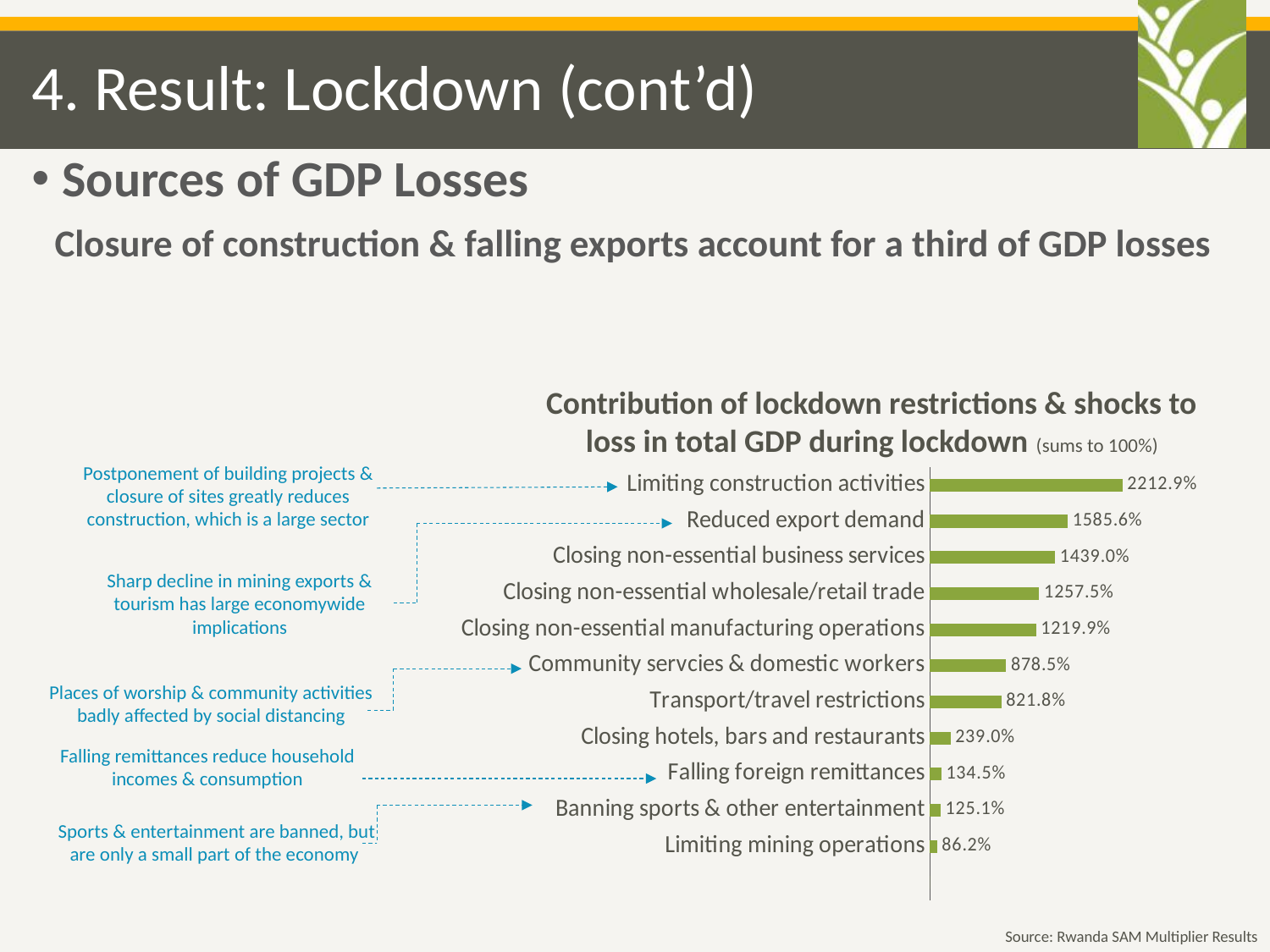
Which is larger, the value for Closing non-essential business services or the value for Closing non-essential manufacturing operations? Closing non-essential business services Which category has the highest value? Limiting construction activities What is the title of the chart? Contribution of lockdown restrictions & shocks to loss in total GDP during lockdown What kind of chart is shown on the slide? Bar chart What is the value for Limiting construction activities? 2212.9% What is the difference between the values for Closing hotels, bars and restaurants and Limiting mining operations? 152.8% What is the value for Transport/travel restrictions? 821.8% What is the difference between the values for Limiting construction activities and Reduced export demand? 627.3% What is the value for Closing non-essential wholesale/retail trade? 1257.5% What is the value for Falling foreign remittances? 134.5% How many categories are shown in the chart? 11 Which category has the lowest value? Limiting mining operations